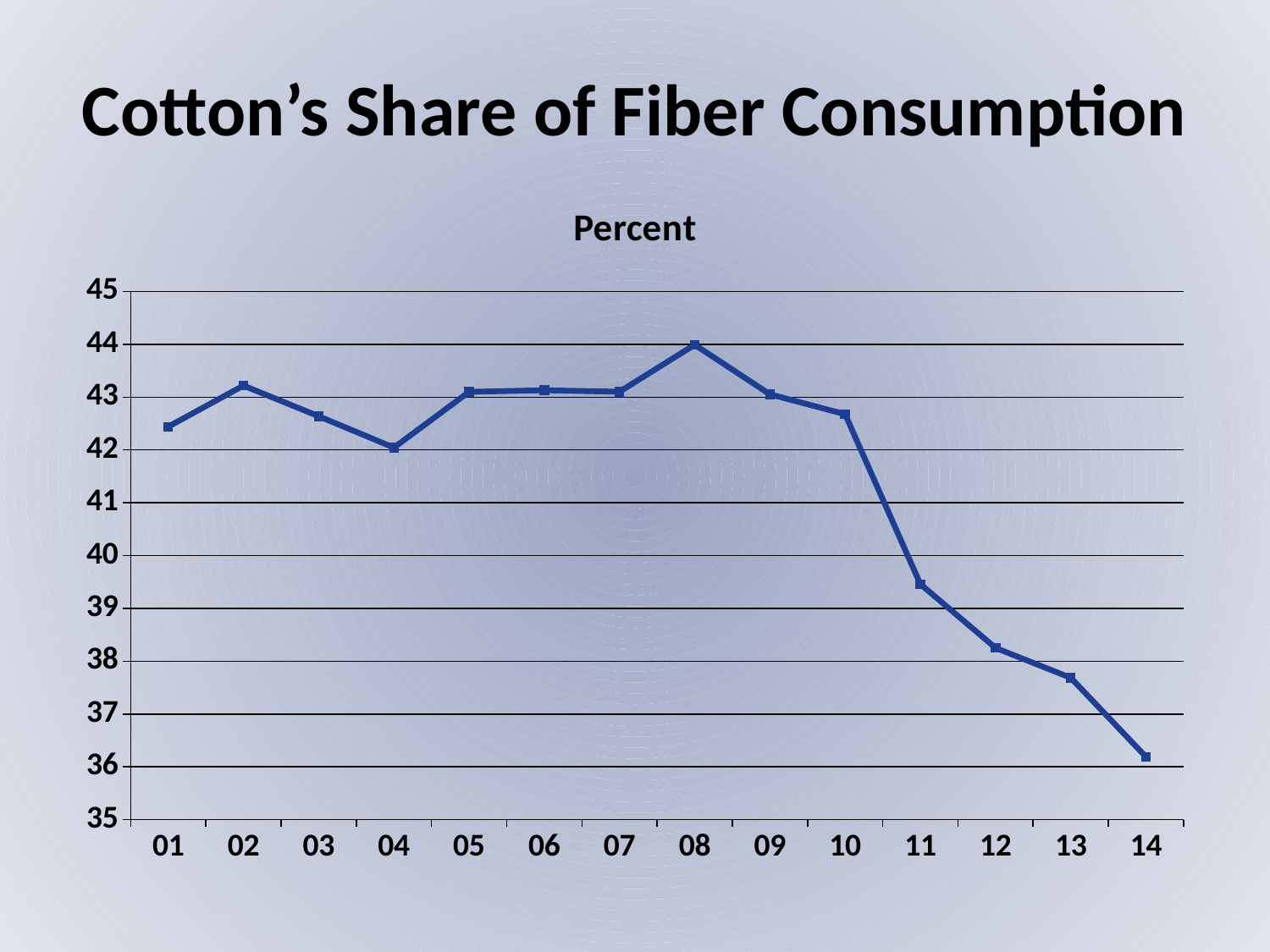
Do the values rise or fall from 10 to 14? fall What is the title of the slide? Cotton's Share of Fiber Consumption Is the value for 14 greater or less than 37? less In which year is cotton's share of fiber consumption highest? 08 What kind of chart is shown on the slide? line chart Is the value for 04 greater or less than 41? greater How many years are plotted along the x axis? 14 Is the value for 08 greater or less than 43? greater What unit label appears above the chart? Percent Which year has the larger value, 11 or 12? 11 In which year is cotton's share of fiber consumption lowest? 14